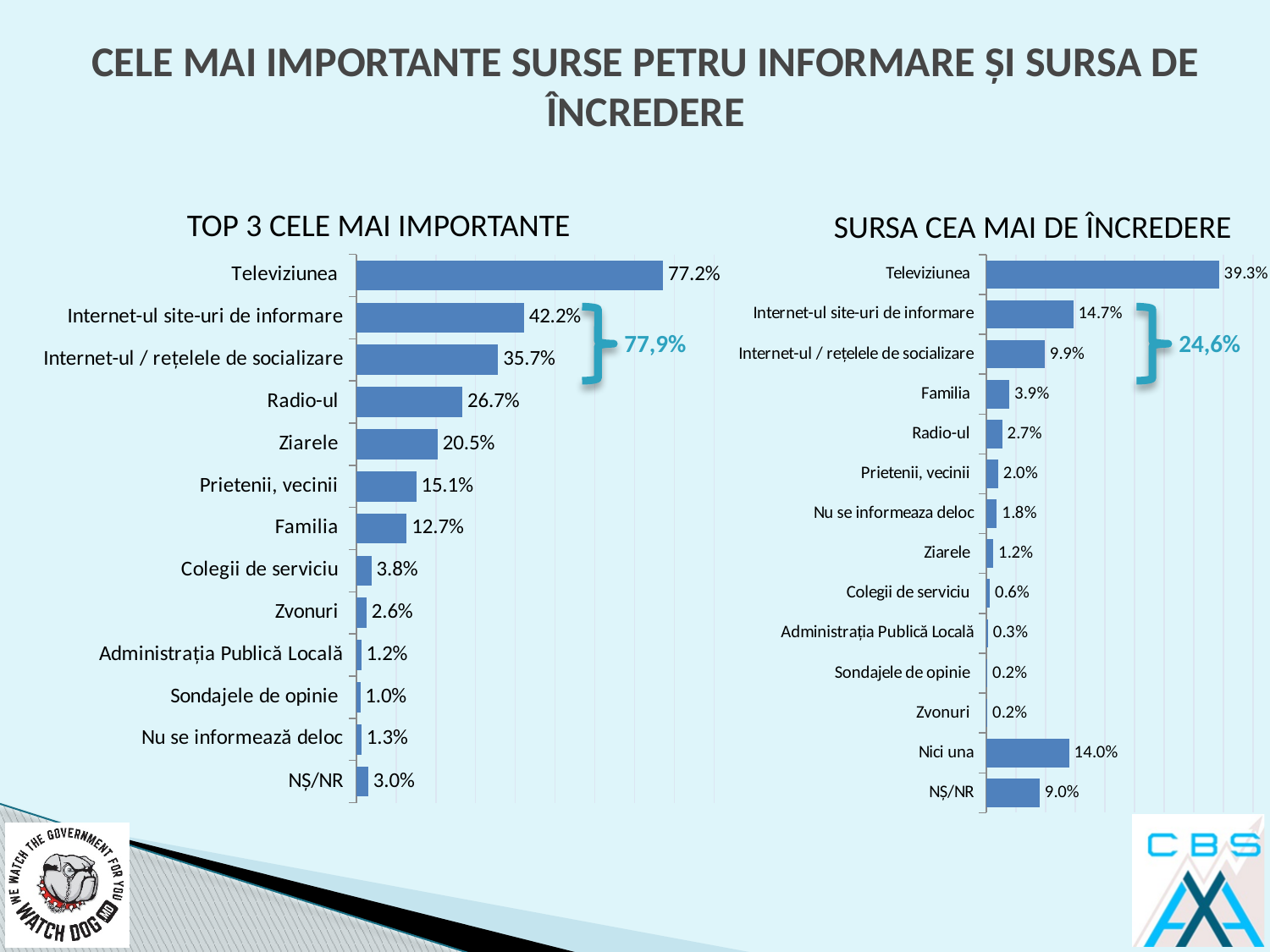
In the 'TOP 3 CELE MAI IMPORTANTE' chart, which is larger: Ziarele or Prietenii, vecinii? Ziarele In the 'SURSA CEA MAI DE ÎNCREDERE' chart, which category has the highest value? Televiziunea In the 'SURSA CEA MAI DE ÎNCREDERE' chart, which is larger: Familia or Radio-ul? Familia How many categories are shown in the 'TOP 3 CELE MAI IMPORTANTE' chart? 13 In the 'TOP 3 CELE MAI IMPORTANTE' chart, what is the value for Radio-ul? 26.7% In the 'TOP 3 CELE MAI IMPORTANTE' chart, what is the difference between Televiziunea and Internet-ul site-uri de informare? 35.0% In the 'SURSA CEA MAI DE ÎNCREDERE' chart, what is the difference between Internet-ul site-uri de informare and Internet-ul / rețelele de socializare? 4.8% What kind of chart is the 'SURSA CEA MAI DE ÎNCREDERE' chart? Bar chart How many categories are shown in the 'SURSA CEA MAI DE ÎNCREDERE' chart? 14 In the 'TOP 3 CELE MAI IMPORTANTE' chart, which category has the lowest value? Sondajele de opinie In the 'TOP 3 CELE MAI IMPORTANTE' chart, what is the value for Televiziunea? 77.2% In the 'SURSA CEA MAI DE ÎNCREDERE' chart, what is the value for Nici una? 14.0%